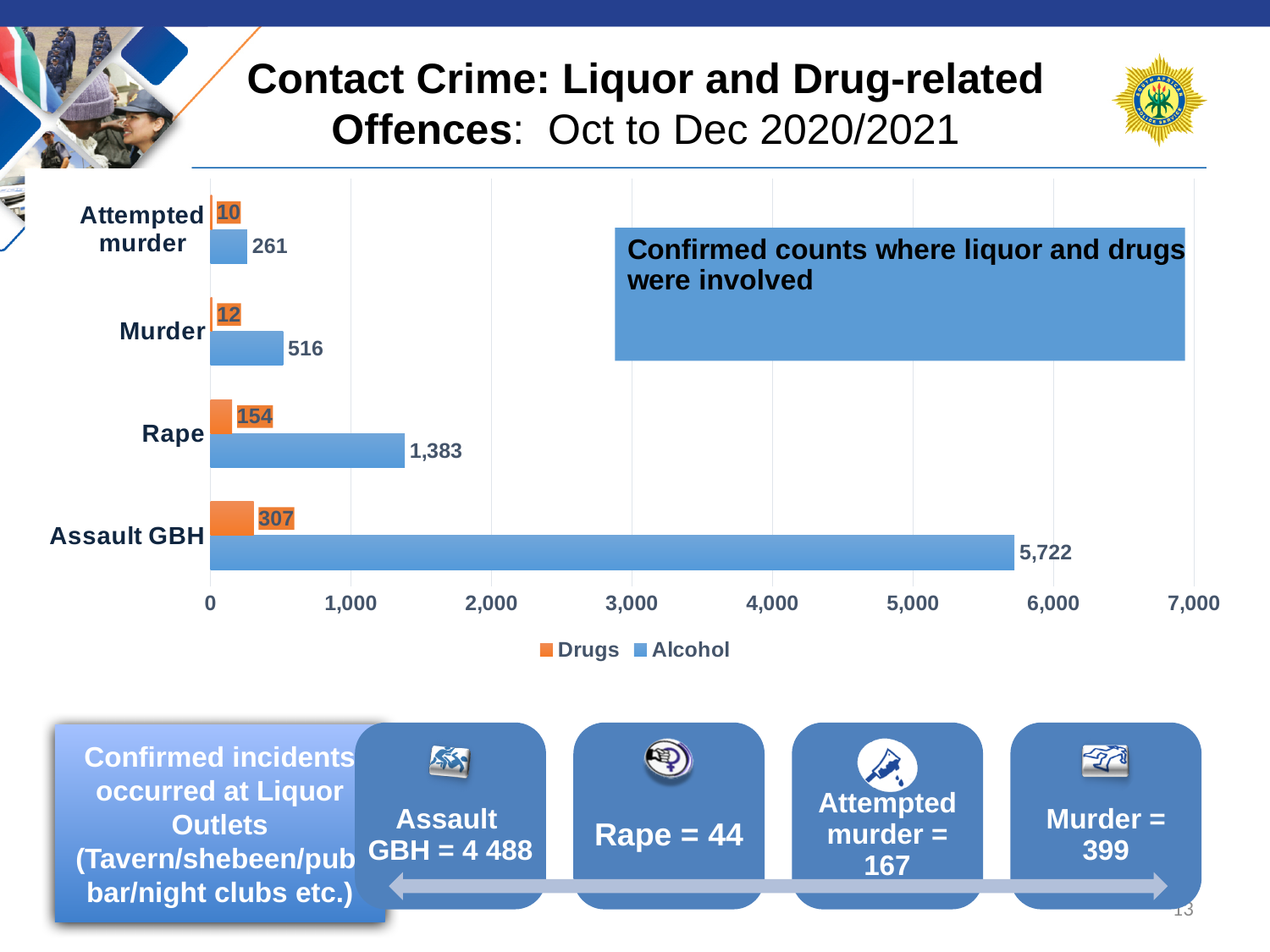
Which category has the highest Alcohol value? Assault GBH What kind of chart is shown on the slide? Bar chart Which category has the lowest Drugs value? Attempted murder What is the Alcohol value for Murder? 516 What is the Alcohol value for Assault GBH? 5,722 What is the difference between the Alcohol and Drugs values for Rape? 1,229 What is the Drugs value for Attempted murder? 10 How many series does the legend list? 2 Is the Alcohol value for Assault GBH greater or less than 5,000? greater Which is larger, the Alcohol value for Murder or the Alcohol value for Attempted murder? Murder How many categories are shown on the chart? 4 What is the Drugs value for Rape? 154